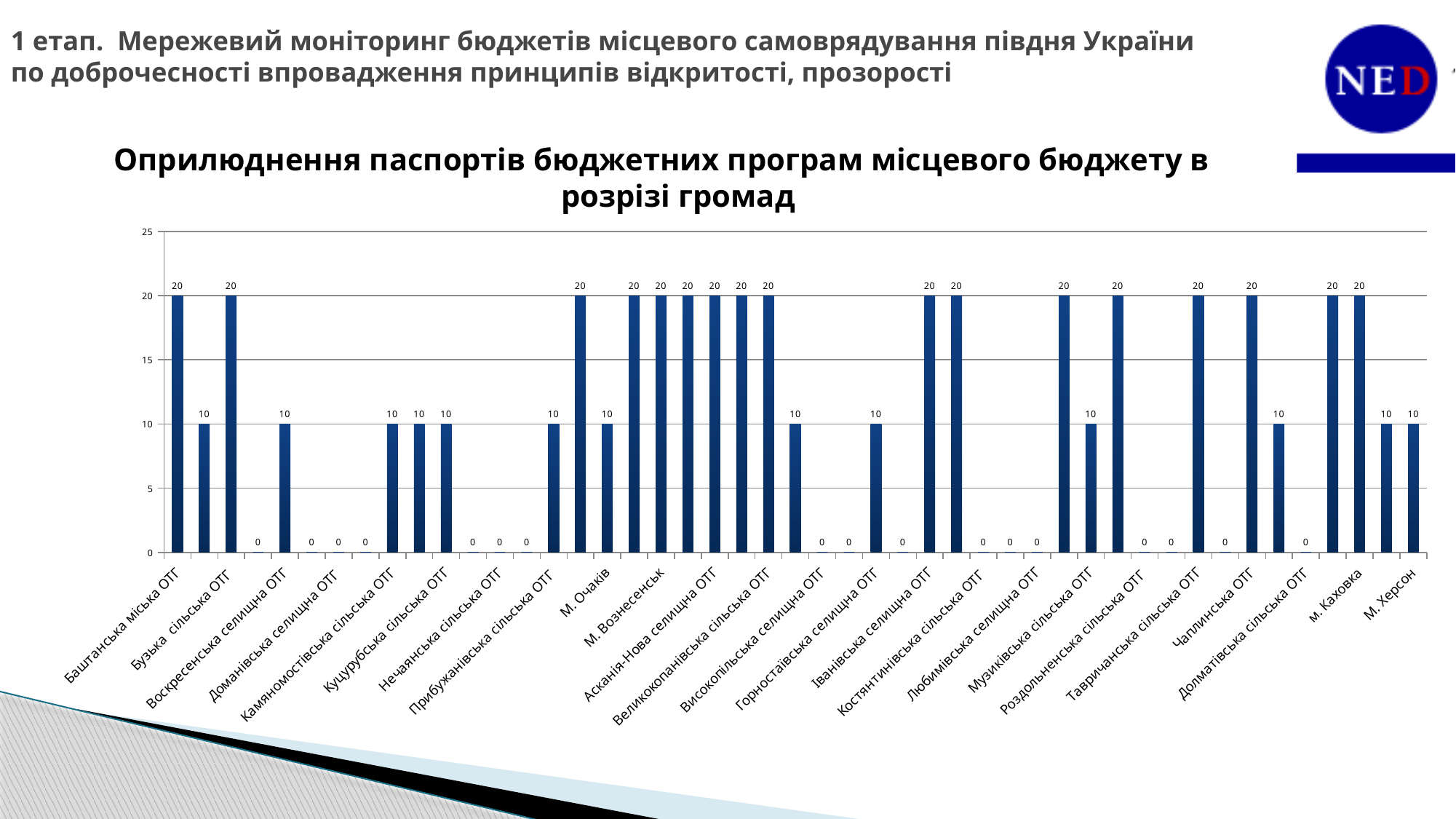
What kind of chart is shown on the slide? bar chart What is the value for Доманівська селищна ОТГ? 0 What is the value for м. Каховка? 20 What is the value for Баштанська міська ОТГ? 20 What is the title of the chart? Оприлюднення паспортів бюджетних програм місцевого бюджету в розрізі громад What is the maximum value shown on the vertical axis? 25 Which is larger, the value for м. Каховка or the value for м. Херсон? м. Каховка What is the value for м. Херсон? 10 What is the value for Бузька сільська ОТГ? 20 What is the highest value shown by any bar in the chart? 20 What is the difference between the value for Баштанська міська ОТГ and the value for м. Херсон? 10 What is the lowest value shown by any bar in the chart? 0